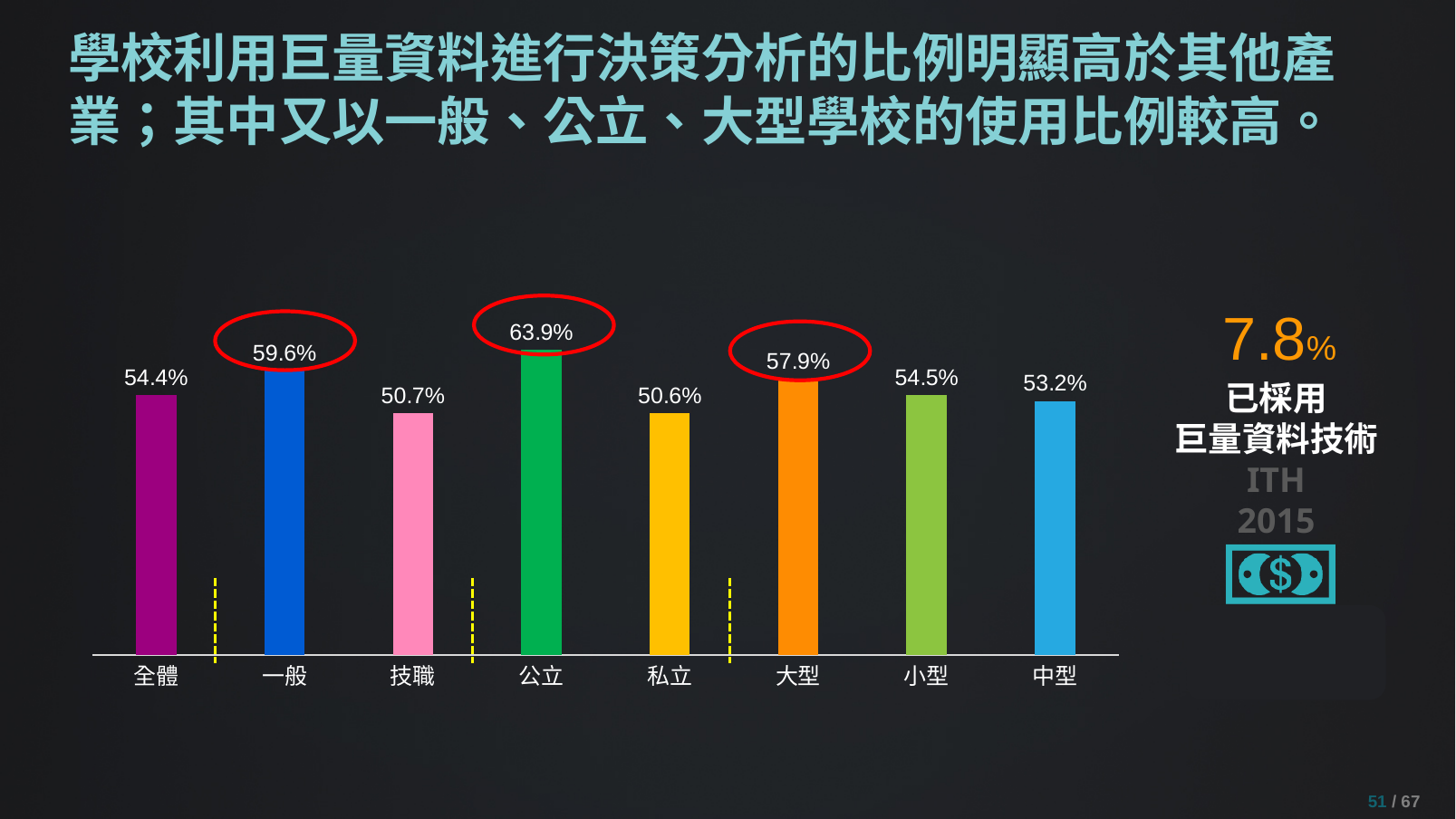
Which category has the highest value? 公立 What is the value for 公立? 63.9% How many categories are shown on the x axis? 8 Which category has the lowest value? 私立 What is the value for 大型? 57.9% How many bars are circled in red? 3 What is the difference between the values for 公立 and 私立? 13.3% What is the difference between the values for 一般 and 技職? 8.9% What is the value for 私立? 50.6% What kind of chart is shown on the slide? Bar chart What is the value for 全體? 54.4% Which is larger, the value for 大型 or the value for 中型? 大型